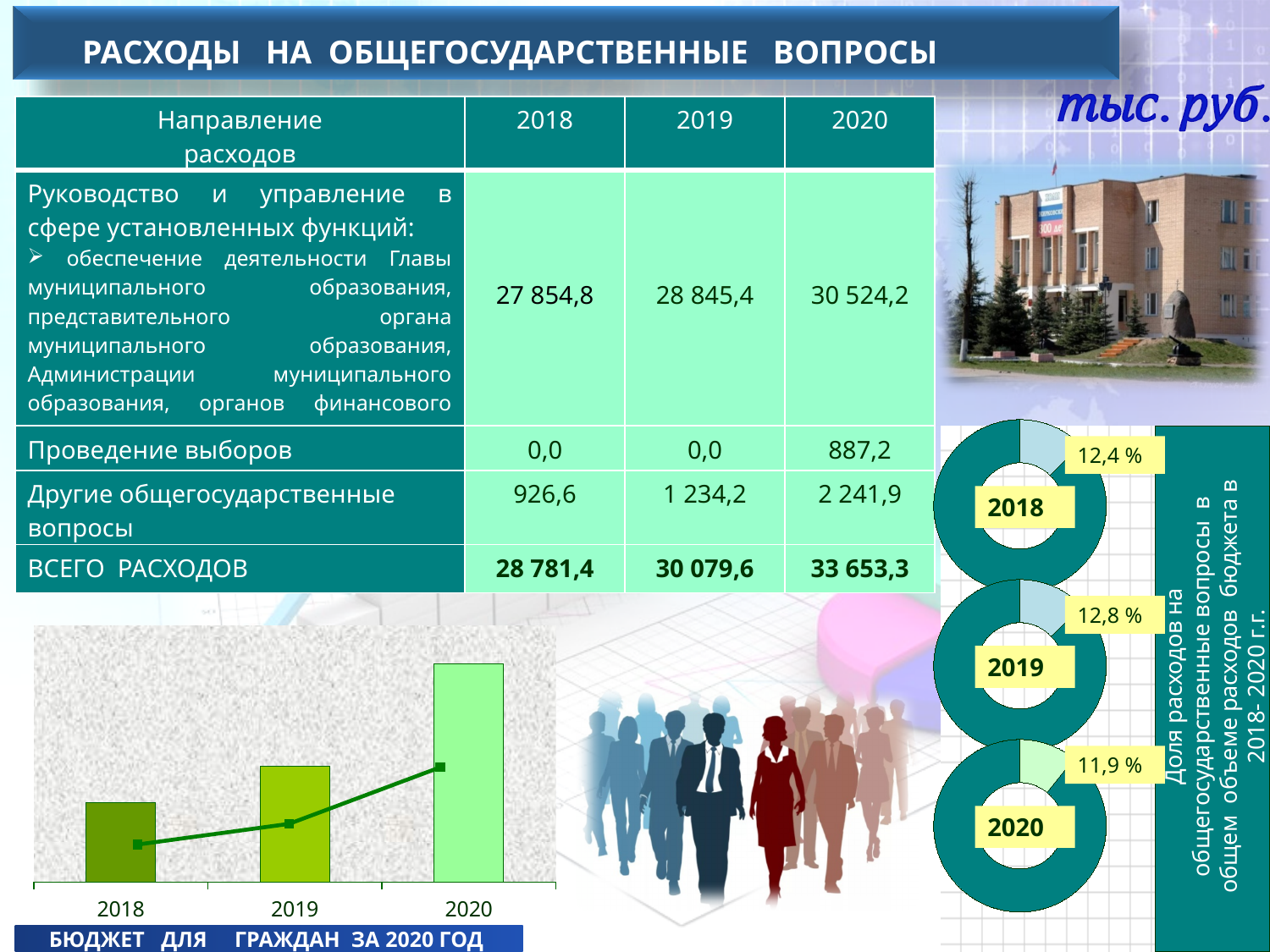
In the bar chart at the bottom left, which year has the shortest bar? 2018 How many categories are shown on the x axis of the bar chart at the bottom left? 3 In the donut charts on the right, what share is shown for 2019? 12,8 % In the bar chart at the bottom left, do the bars rise or fall from 2018 to 2020? rise Among the donut charts on the right, which year has the highest share? 2019 Among the donut charts on the right, which year has the lowest share? 2020 What kind of chart is shown at the bottom left of the slide? bar chart with a line In the bar chart at the bottom left, which year has the tallest bar? 2020 In the bar chart at the bottom left, does the line rise or fall from 2018 to 2020? rise In the donut charts on the right, what share is shown for 2018? 12,4 % In the bar chart at the bottom left, is the bar for 2019 taller or shorter than the bar for 2020? shorter In the donut charts on the right, what share is shown for 2020? 11,9 %